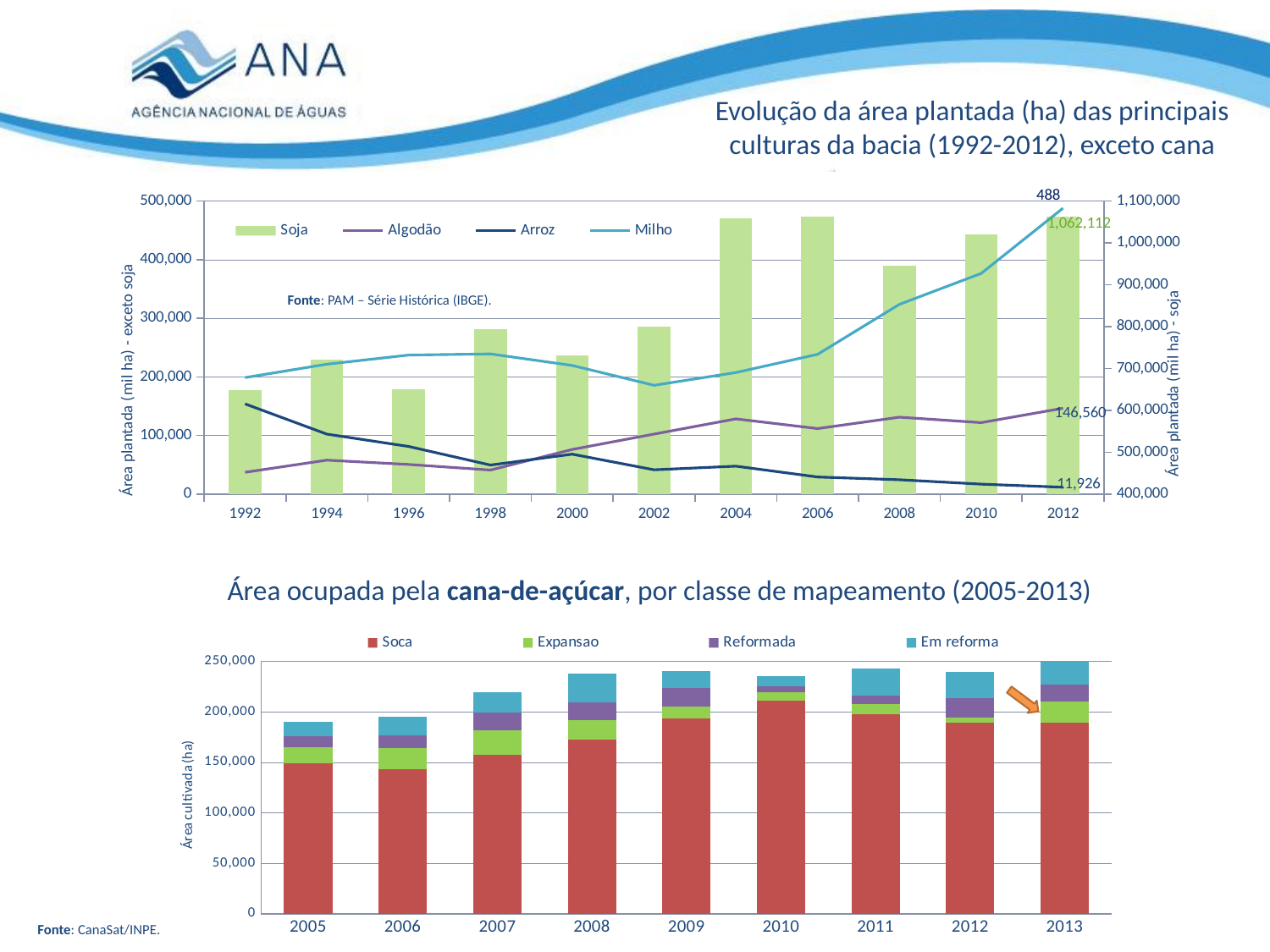
In the bottom chart (Área ocupada pela cana-de-açúcar), is the Soca value for 2010 greater or less than 200,000? greater In the top chart (Evolução da área plantada), does the Arroz line rise or fall from 1992 to 2012? fall In the top chart (Evolução da área plantada), what is the value for Arroz in 2012? 11,926 In the top chart (Evolução da área plantada), what is the difference between the Algodão and Arroz values in 2012? 134,634 What kind of chart is the bottom chart (Área ocupada pela cana-de-açúcar)? stacked bar chart In the top chart (Evolução da área plantada), how many series does the legend list? 4 In the top chart (Evolução da área plantada), how many years are shown on the x axis? 11 In the top chart (Evolução da área plantada), which is larger in 1992, Arroz or Algodão? Arroz In the top chart (Evolução da área plantada), is the Milho value in 1992 greater or less than 300,000? less In the bottom chart (Área ocupada pela cana-de-açúcar), how many years are shown on the x axis? 9 In the top chart (Evolução da área plantada), what is the value of the Soja bar in 2012? 1,062,112 In the top chart (Evolução da área plantada), what is the value for Algodão in 2012? 146,560